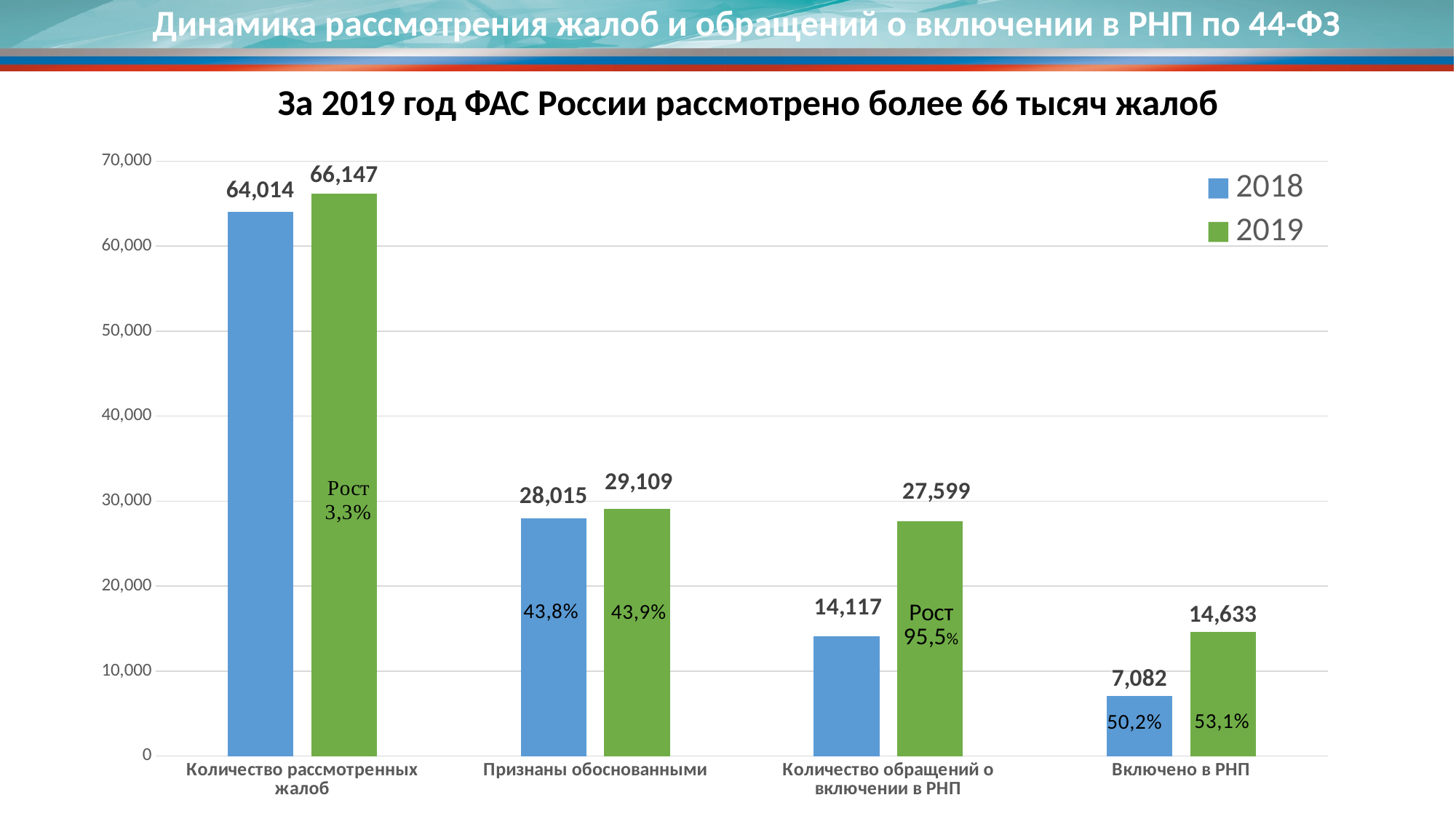
Which category has the highest 2019 value? Количество рассмотренных жалоб What is the 2019 value for "Количество рассмотренных жалоб"? 66,147 What is the difference between the 2019 and 2018 values for "Количество обращений о включении в РНП"? 13,482 How many series does the legend list? 2 Which is larger: the 2018 value for "Признаны обоснованными" or the 2019 value for "Признаны обоснованными"? 2019 (29,109) What is the 2018 value for "Количество обращений о включении в РНП"? 14,117 How many categories are shown on the x axis? 4 What is the 2018 value for "Включено в РНП"? 7,082 What is the difference between the 2019 and 2018 values for "Включено в РНП"? 7,551 What type of chart is shown on the slide? Bar chart Which category has the lowest 2018 value? Включено в РНП Is the 2019 value for "Признаны обоснованными" greater or less than 30,000? less